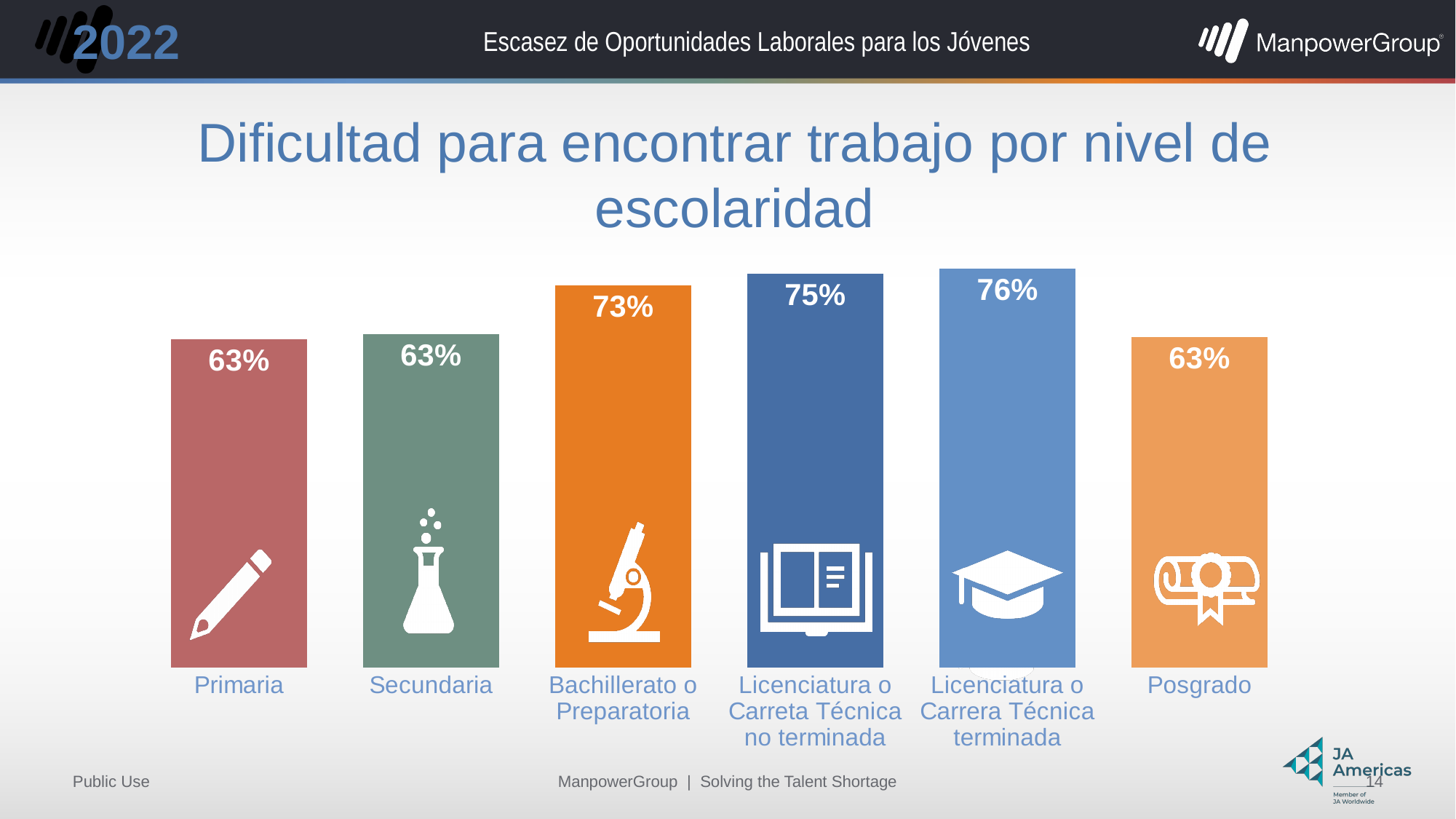
Which is larger, the value for Bachillerato o Preparatoria or the value for Secundaria? Bachillerato o Preparatoria What is the value for Primaria? 63% What is the difference between the values for Licenciatura o Carreta Técnica no terminada and Bachillerato o Preparatoria? 2% Which category has the highest value? Licenciatura o Carrera Técnica terminada How many categories are shown in the chart? 6 What kind of chart is shown on the slide? Bar chart What is the value for Posgrado? 63% What is the value for Bachillerato o Preparatoria? 73% What is the difference between the values for Licenciatura o Carrera Técnica terminada and Primaria? 13% What is the value for Licenciatura o Carrera Técnica terminada? 76% What is the title of the chart? Dificultad para encontrar trabajo por nivel de escolaridad How many categories have a value of 63%? 3